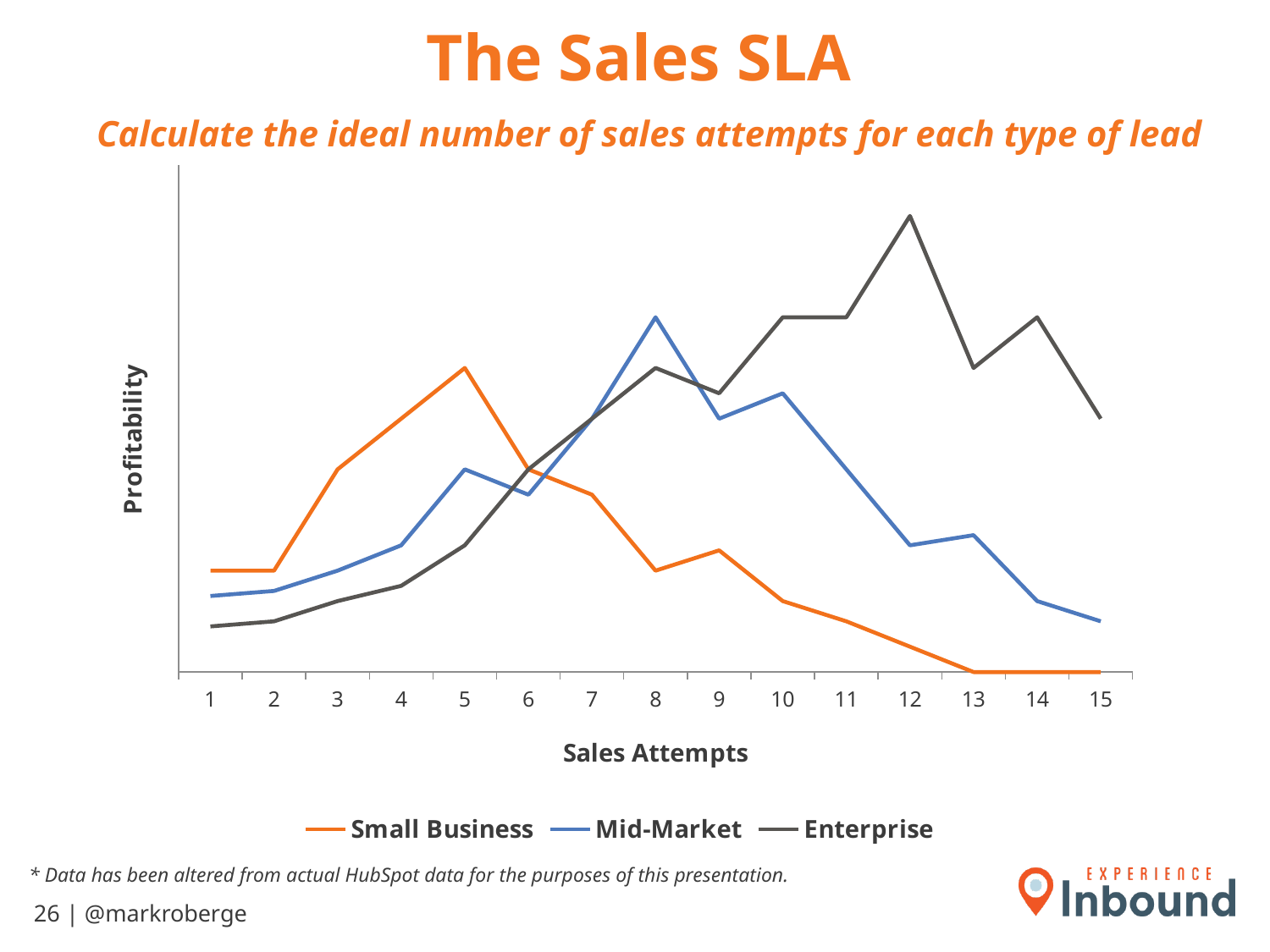
At 12 sales attempts, which is higher: Enterprise or Mid-Market? Enterprise Which series reaches the highest profitability anywhere on the chart? Enterprise How many sales attempt values are shown along the x axis? 15 What is the label on the x axis of the chart? Sales Attempts At which number of sales attempts does the Enterprise line reach its highest profitability? 12 How many series does the legend list? 3 Does the Small Business line rise or fall between 5 and 13 sales attempts? Fall At which number of sales attempts does the Mid-Market line reach its highest profitability? 8 What kind of chart is shown on the slide? Line chart At 3 sales attempts, which is higher: Small Business or Enterprise? Small Business Which series has the lowest profitability at 1 sales attempt? Enterprise